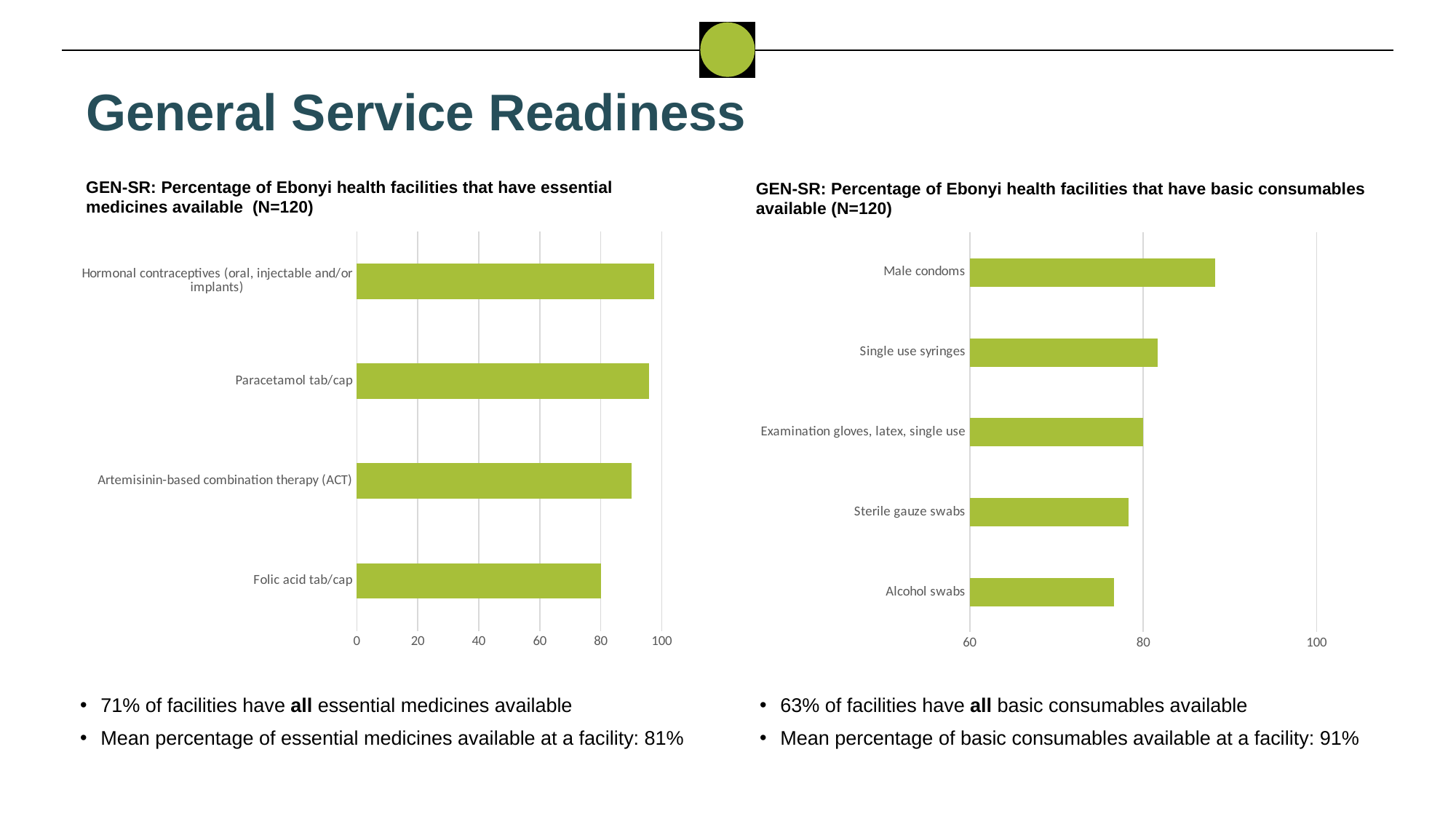
In the chart on the right (basic consumables), which consumable has the highest percentage of facilities with it available? Male condoms In the chart on the left (essential medicines), how many medicines are listed? 4 In the chart on the left (essential medicines), what kind of chart is shown? bar chart In the chart on the right (basic consumables), is the value for Male condoms greater or less than 80? greater In the chart on the right (basic consumables), which is larger: the value for Single use syringes or the value for Alcohol swabs? Single use syringes In the chart on the right (basic consumables), is the value for Sterile gauze swabs greater or less than 80? less In the chart on the left (essential medicines), which medicine has the lowest percentage of facilities with it available? Folic acid tab/cap In the chart on the right (basic consumables), what is the lowest value shown on the horizontal axis? 60 In the chart on the left (essential medicines), is the value for Folic acid tab/cap greater or less than 60? greater In the chart on the right (basic consumables), how many consumables are listed? 5 In the chart on the left (essential medicines), which is larger: the value for Paracetamol tab/cap or the value for Folic acid tab/cap? Paracetamol tab/cap